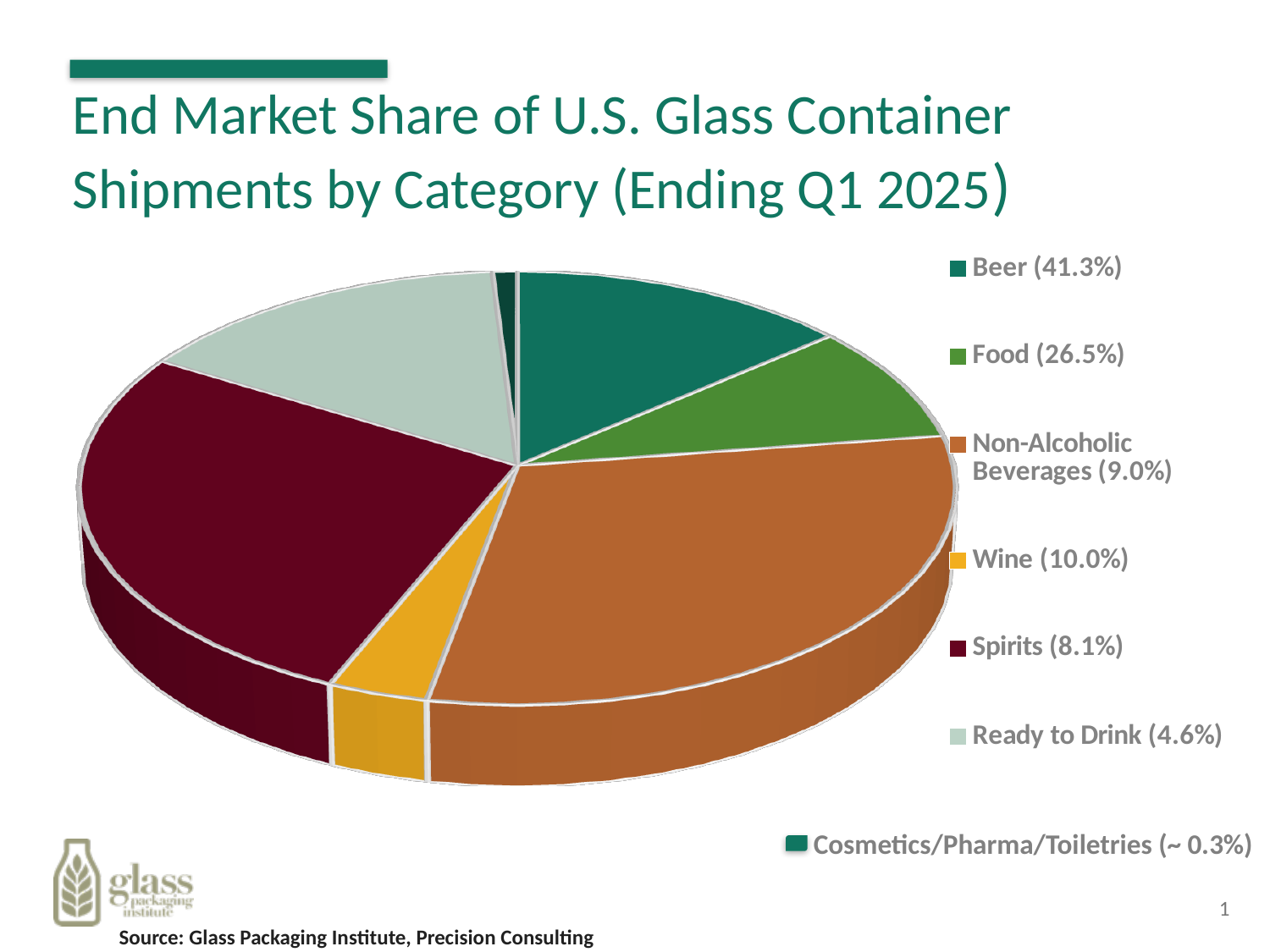
What share is shown for Non-Alcoholic Beverages? 9.0% Which category has the largest share of shipments? Beer What type of chart is shown on the slide? Pie chart What share is shown for Food? 26.5% What is the title of the chart? End Market Share of U.S. Glass Container Shipments by Category (Ending Q1 2025) How many categories are listed in the legend? 7 Which category has the smallest share of shipments? Cosmetics/Pharma/Toiletries What is the combined share of Beer and Food? 67.8% What share of U.S. glass container shipments does Beer account for? 41.3% What is the difference in share between Beer and Food? 14.8% What share is shown for Ready to Drink? 4.6% Which has a larger share, Wine or Spirits? Wine